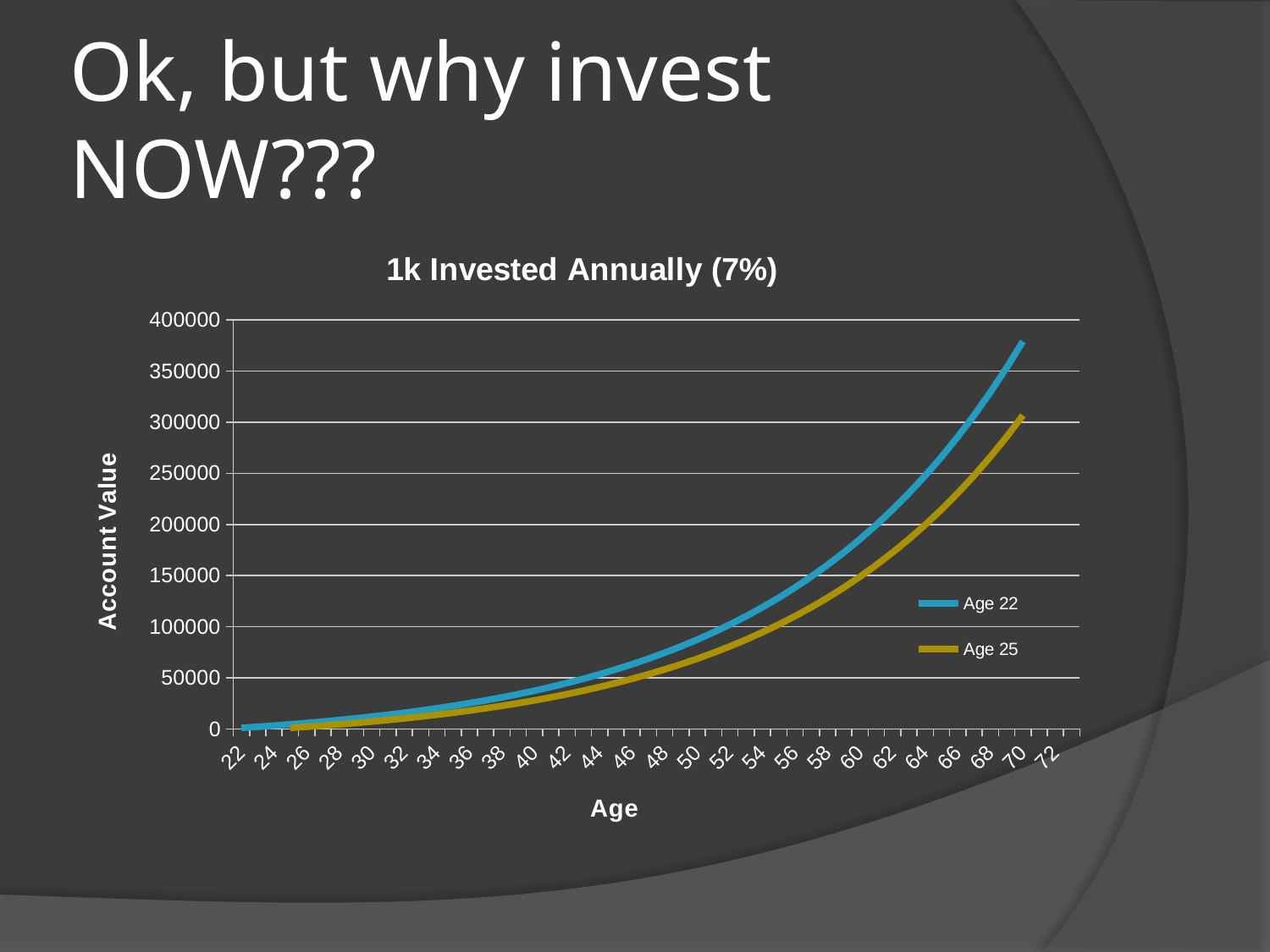
Is the value for the Age 25 series at age 70 greater or less than 350000? less At age 70, which series has the higher account value, Age 22 or Age 25? Age 22 What is the title of the chart? 1k Invested Annually (7%) Do the account values rise or fall as age increases along the x axis? rise At age 60, which series has the higher account value, Age 22 or Age 25? Age 22 Which series reaches the highest account value on the chart? Age 22 Is the value for the Age 25 series at age 40 greater or less than 50000? less Is the value for the Age 22 series at age 70 greater or less than 350000? greater What is the label of the vertical axis? Account Value What kind of chart is shown on the slide? line chart How many series does the legend list? 2